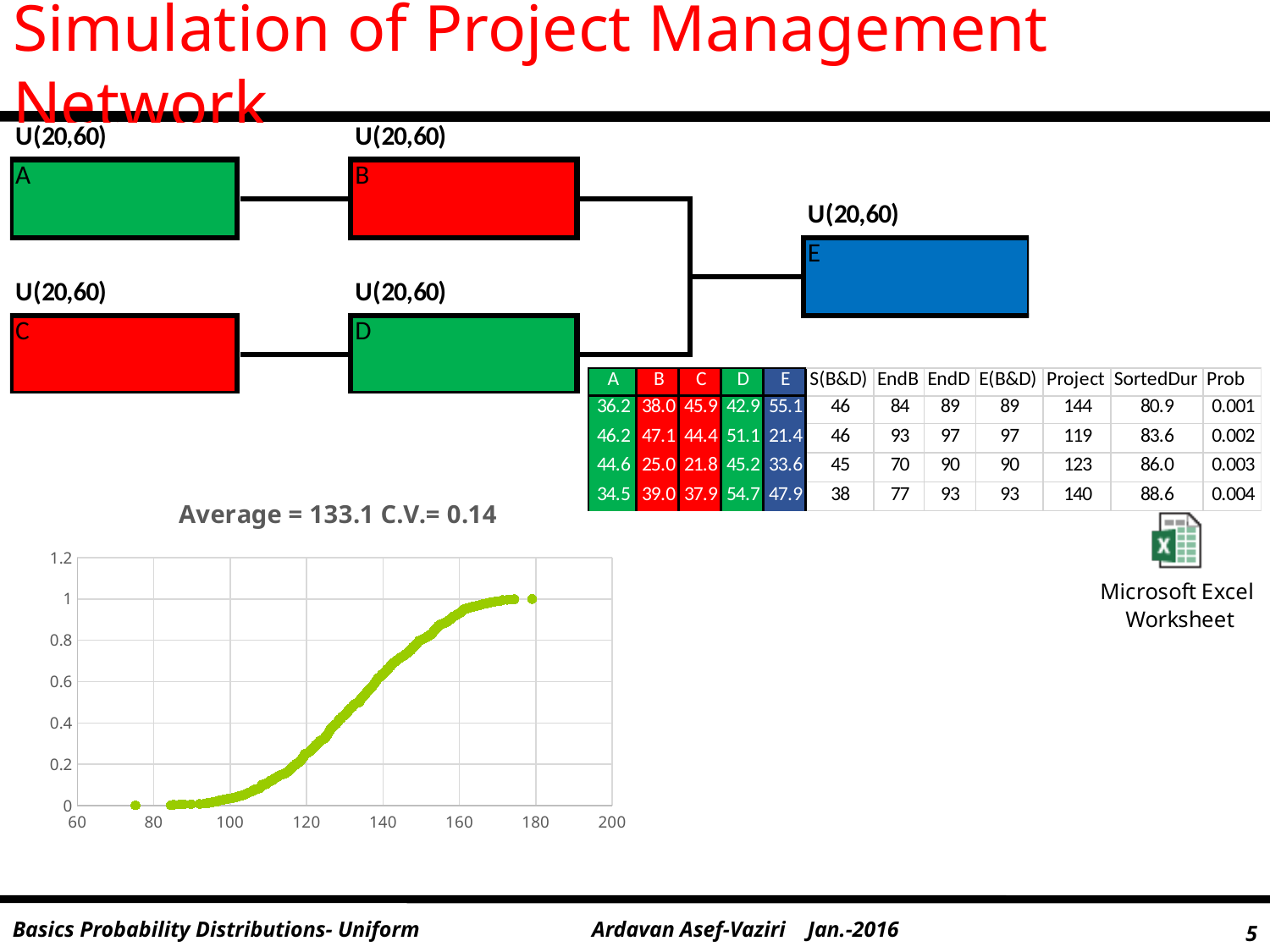
Is the plotted value at x = 140 greater or less than 0.8? less Is the plotted value at x = 120 greater or less than 0.4? less Is the plotted value at x = 160 greater or less than 0.8? greater Do the plotted values rise or fall as the x axis increases from 60 to 200? rise What is the highest value shown on the chart's y axis? 1.2 What is the title of the chart? Average = 133.1 C.V.= 0.14 What kind of chart is shown on the slide? scatter chart